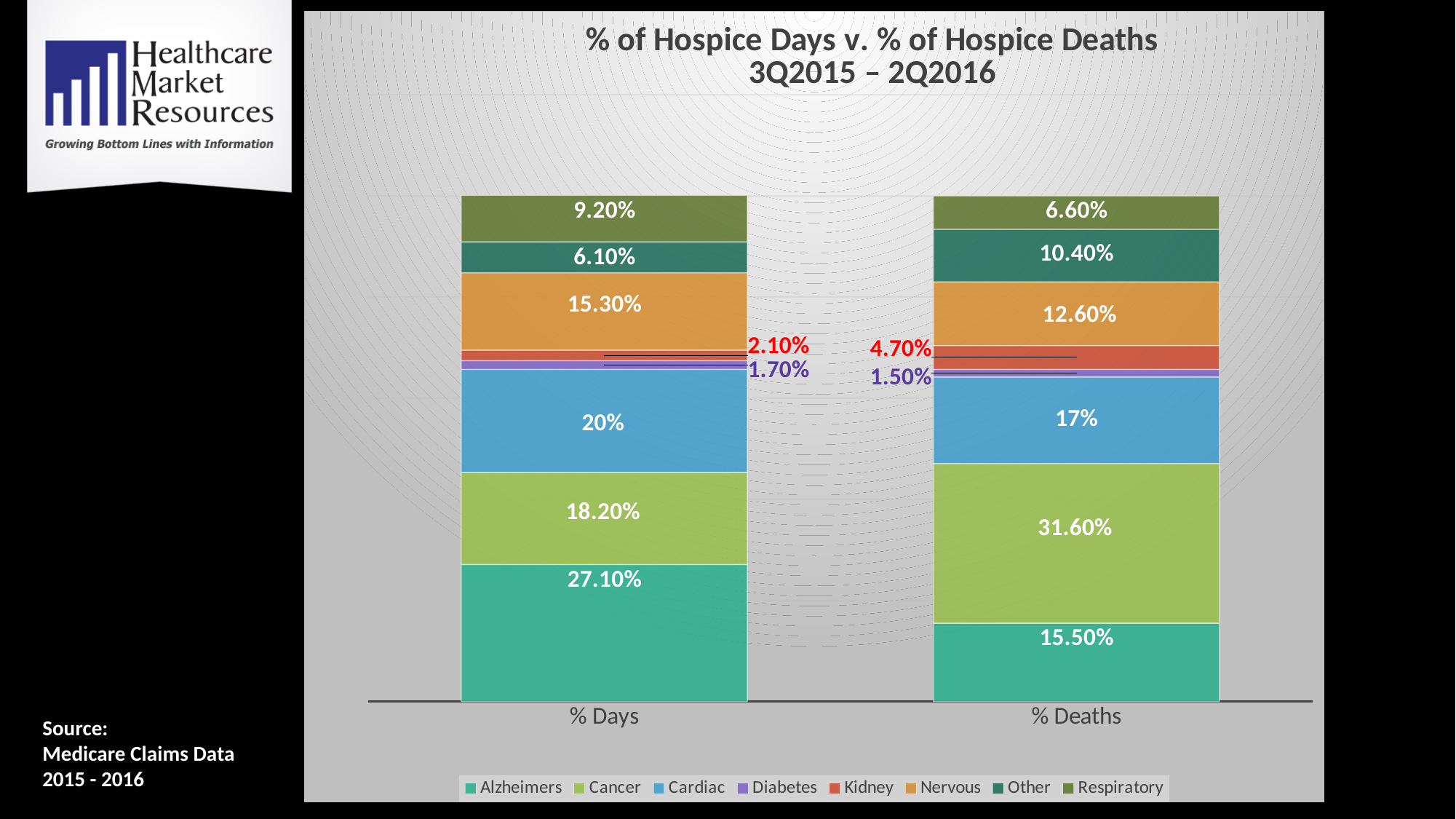
What is the title of the chart? % of Hospice Days v. % of Hospice Deaths 3Q2015 – 2Q2016 How many series does the legend list? 8 What is the difference between the Cancer value for % Deaths and the Cancer value for % Days? 13.40% What is the Cancer value in the % Deaths bar? 31.60% Which series has the smallest segment in the % Deaths bar? Diabetes Is the Cardiac value larger for % Days or for % Deaths? % Days What is the Alzheimers value in the % Days bar? 27.10% Which series has the largest segment in the % Days bar? Alzheimers How many bars are plotted on the chart? 2 What kind of chart is shown on the slide? Stacked bar chart What is the Nervous value in the % Days bar? 15.30% What is the Kidney value in the % Deaths bar? 4.70%